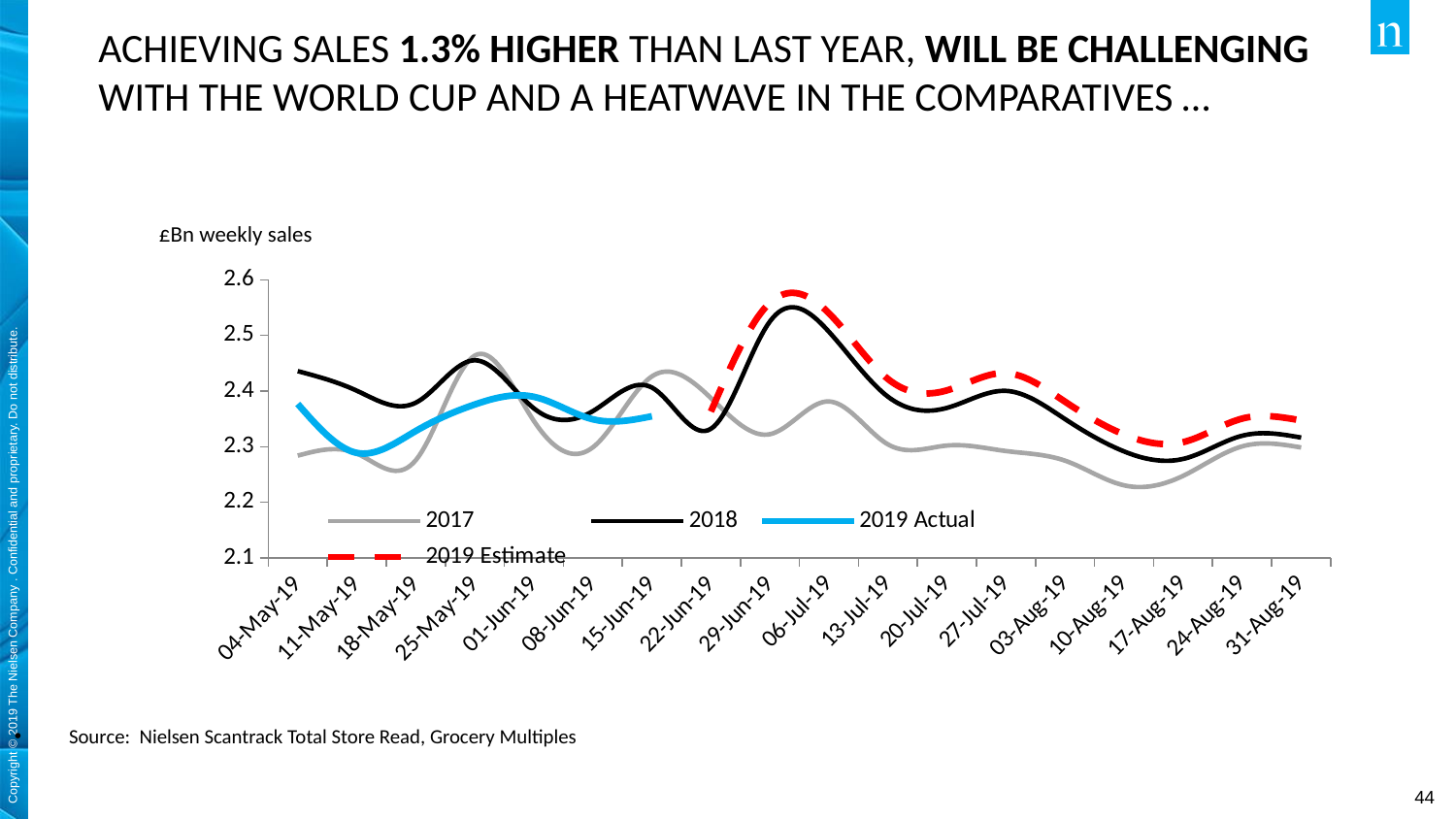
Is the value for 2019 Estimate at 06-Jul-19 greater or less than 2.5? greater On which date does the 2018 series reach its highest value? 29-Jun-19 How many series does the legend list? 4 At 04-May-19, which series is higher, 2017 or 2018? 2018 Is the value for 2017 at 10-Aug-19 greater or less than 2.3? less At 06-Jul-19, which series is higher, 2017 or 2018? 2018 What is the label shown above the y axis of the chart? £Bn weekly sales Does the 2018 series rise or fall between 06-Jul-19 and 17-Aug-19? fall Is the value for 2019 Actual at 04-May-19 greater or less than 2.3? greater How many dates are labelled on the x axis? 18 What type of chart is shown on the slide? line chart